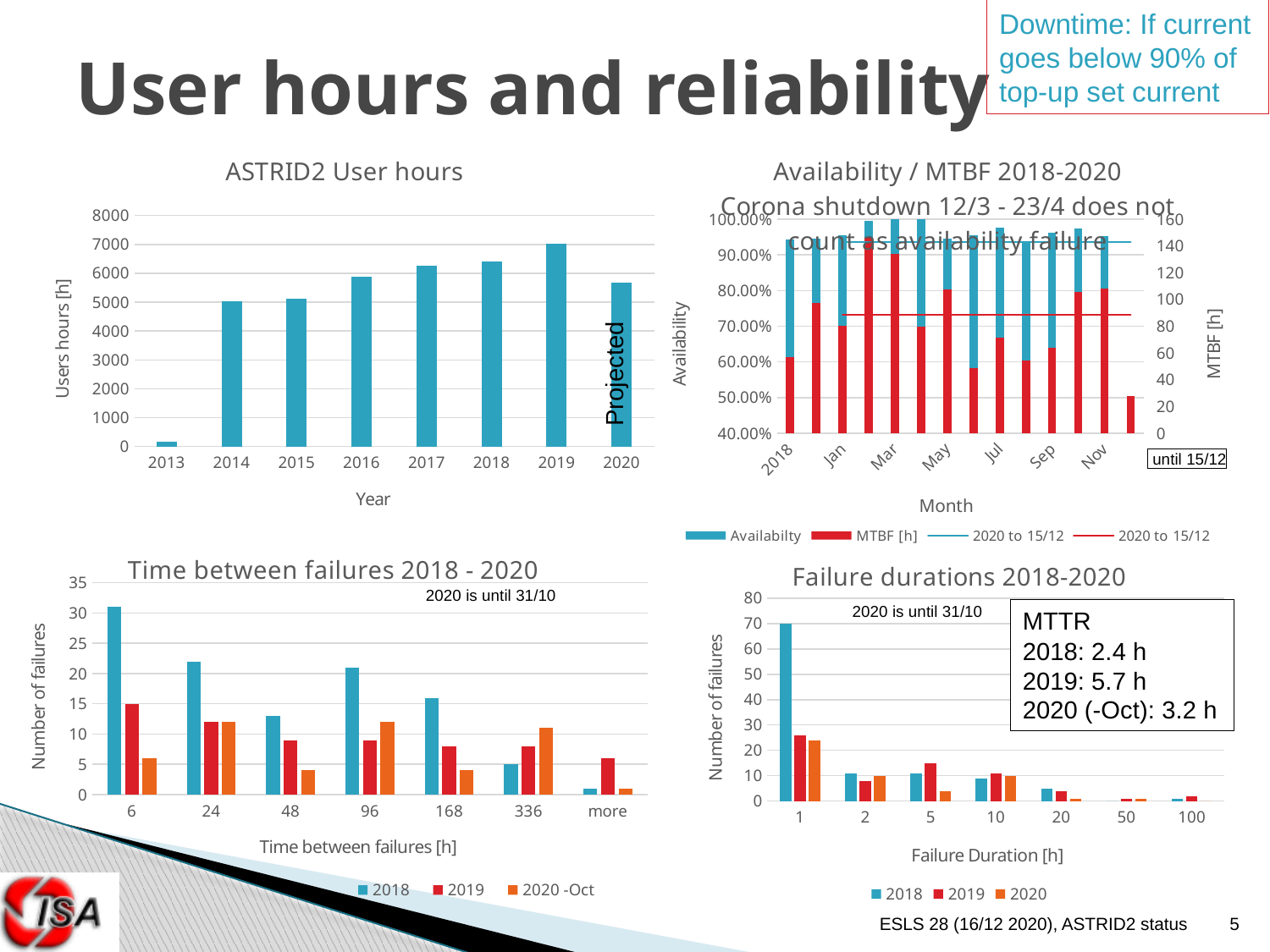
In the Time between failures 2018 - 2020 chart, how many categories are shown on the x axis? 7 In the ASTRID2 User hours chart, is the value for 2013 greater or less than 1000? less In the ASTRID2 User hours chart, which year is labelled as projected? 2020 What kind of chart is the ASTRID2 User hours chart? bar chart In the ASTRID2 User hours chart, which year has the highest user hours? 2019 In the Failure durations 2018-2020 chart, is the 2018 value for a failure duration of 1 h greater or less than 60? greater In the Time between failures 2018 - 2020 chart, which series has the tallest bar in the 6 h category? 2018 In the ASTRID2 User hours chart, is the value for 2019 greater or less than 6000? greater How many series does the legend of the Availability / MTBF 2018-2020 chart list? 4 In the ASTRID2 User hours chart, how many years are shown on the x axis? 8 In the ASTRID2 User hours chart, which year has the lowest user hours? 2013